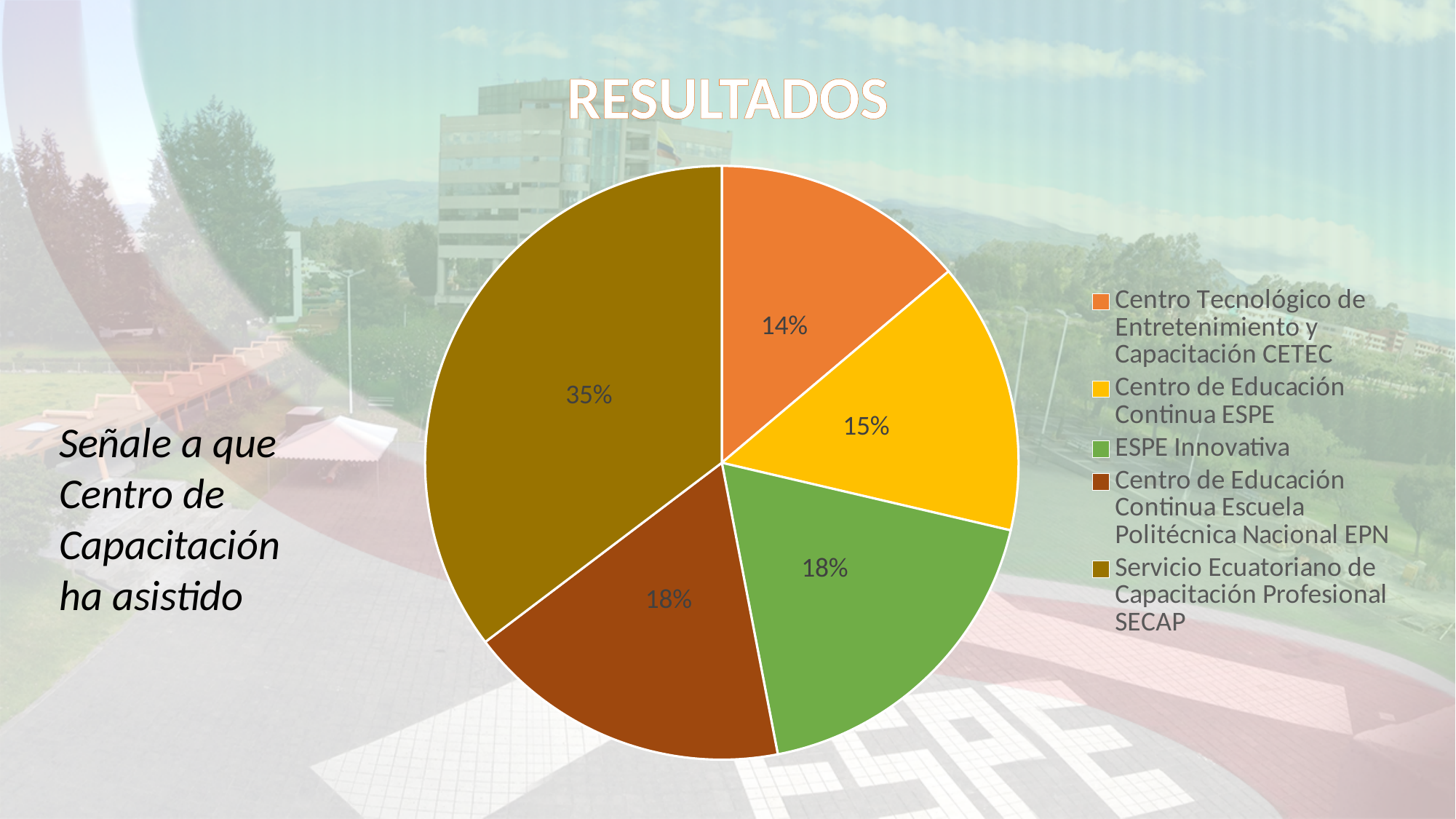
What percentage is shown for Centro de Educación Continua ESPE? 15% What is the difference in percentage points between SECAP and ESPE Innovativa? 17 What is the title shown above the chart? RESULTADOS Which training centre has the largest slice of the pie? Servicio Ecuatoriano de Capacitación Profesional SECAP How many slices does the pie chart have? 5 What kind of chart is shown on the slide? Pie chart Which training centre has the smallest slice of the pie? Centro Tecnológico de Entretenimiento y Capacitación CETEC What percentage is shown for Centro Tecnológico de Entretenimiento y Capacitación CETEC? 14% What percentage is shown for Centro de Educación Continua Escuela Politécnica Nacional EPN? 18% Which is larger, the slice for Centro de Educación Continua ESPE or the slice for SECAP? SECAP What share of the pie does Servicio Ecuatoriano de Capacitación Profesional SECAP hold? 35% What percentage is shown for ESPE Innovativa? 18%